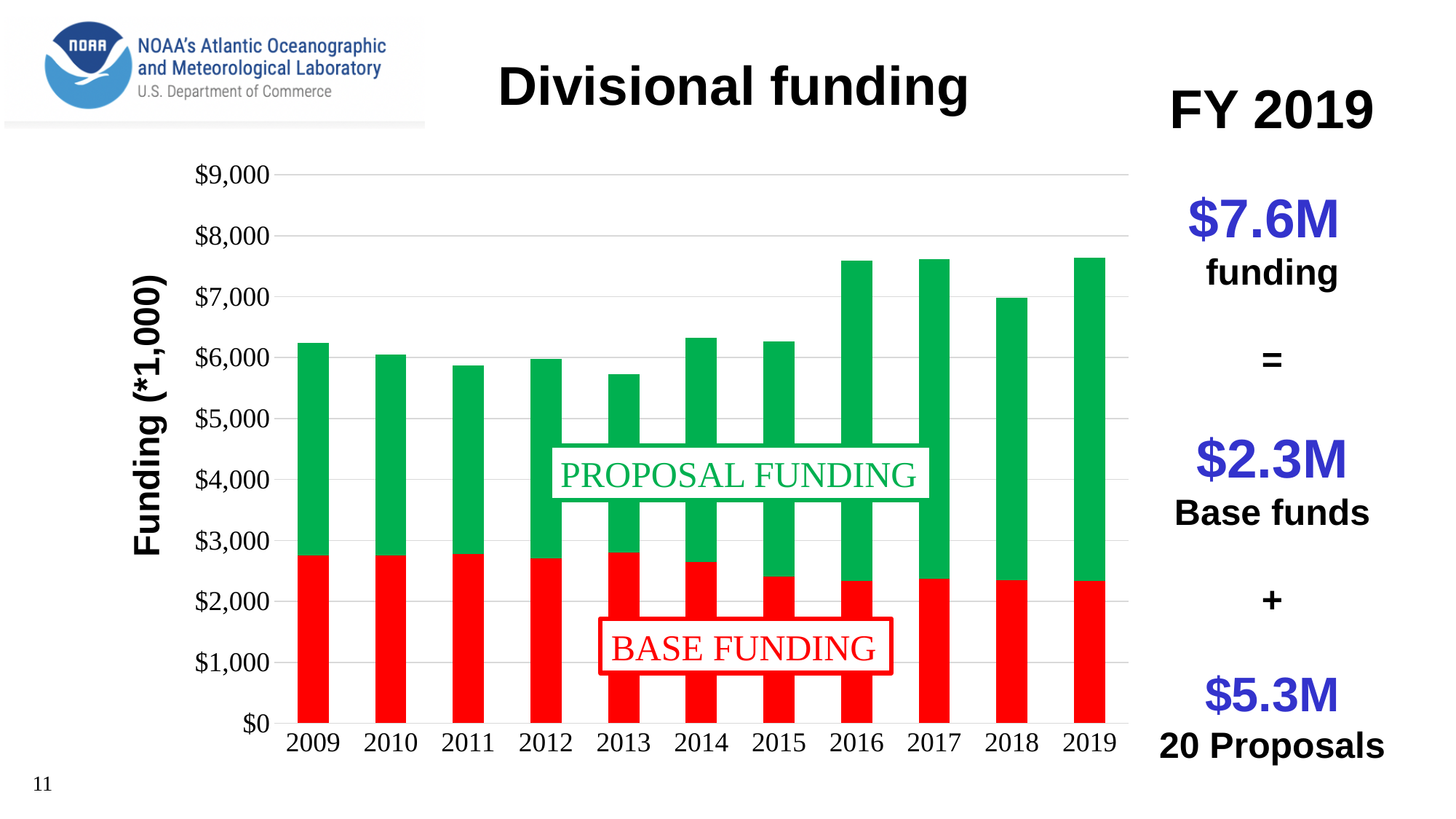
How many funding series are stacked in each bar? 2 Is the base funding for 2015 greater or less than $2,000? greater Is the base funding for 2009 greater or less than $3,000? less Which year has the larger total funding, 2014 or 2011? 2014 What is the label on the y axis of the chart? Funding (*1,000) Is the total funding for 2016 greater or less than $7,000? greater What colour represents base funding in the chart? Red Which year has the larger base funding, 2009 or 2019? 2009 Which year has the lowest total funding? 2013 What kind of chart is shown on the slide? Stacked bar chart How many years are shown on the x axis of the chart? 11